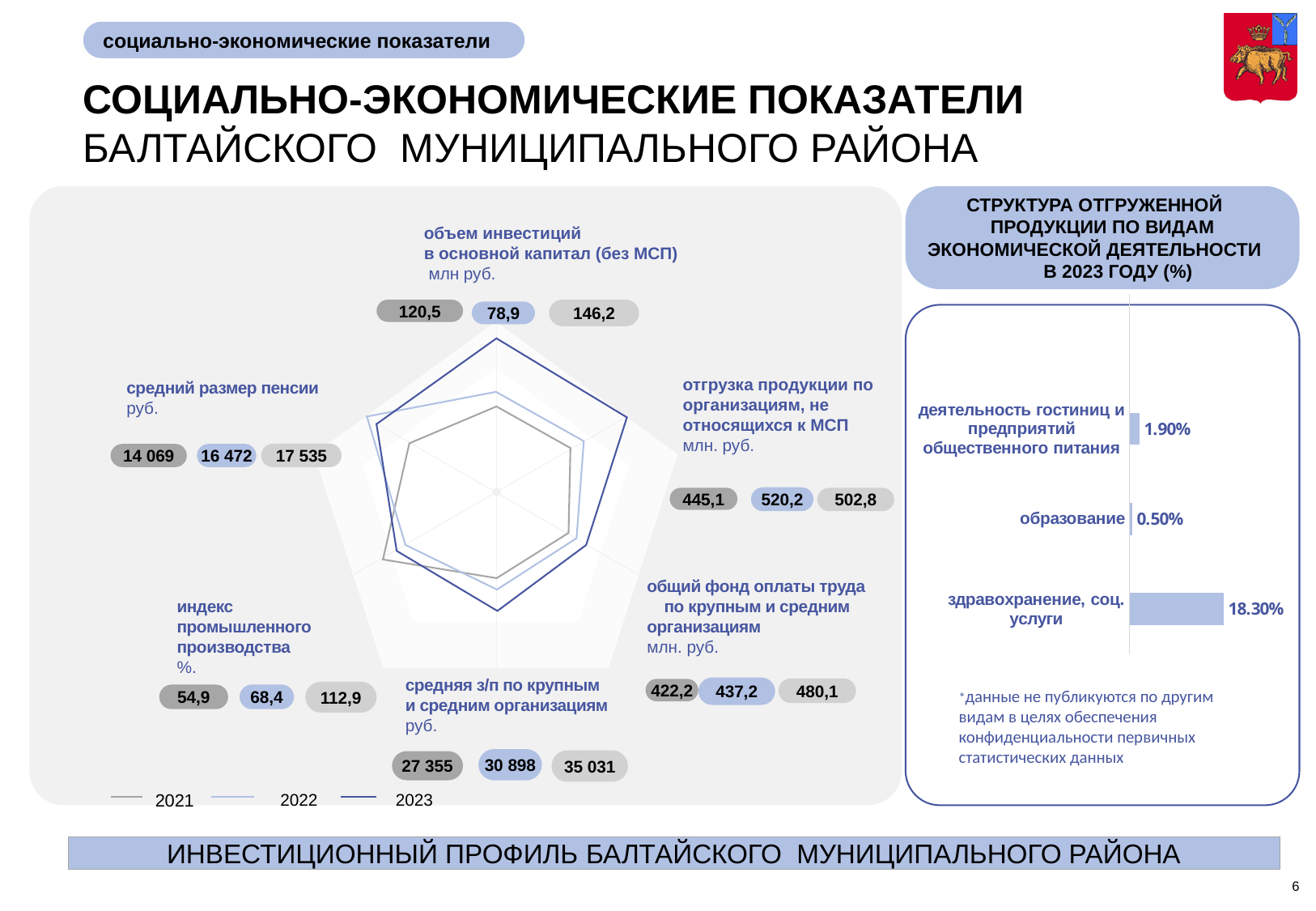
What kind of chart is the chart on the right of the slide? bar chart In the bar chart on the right, what is the value for здравоохранение, соц. услуги? 18.30% What kind of chart is the chart on the left of the slide? radar chart In the bar chart on the right, which category has the lowest value? образование In the bar chart on the right, what is the difference between the value for здравоохранение, соц. услуги and the value for деятельность гостиниц и предприятий общественного питания? 16.40% In the radar chart on the left, which year does the dark blue line represent according to the legend? 2023 How many indicators (axes) does the radar chart on the left have? 6 How many categories are shown in the bar chart on the right? 3 How many series does the legend of the radar chart on the left list? 3 In the bar chart on the right, which category has the highest value? здравоохранение, соц. услуги In the bar chart on the right, what is the value for деятельность гостиниц и предприятий общественного питания? 1.90% In the bar chart on the right, what is the value for образование? 0.50%